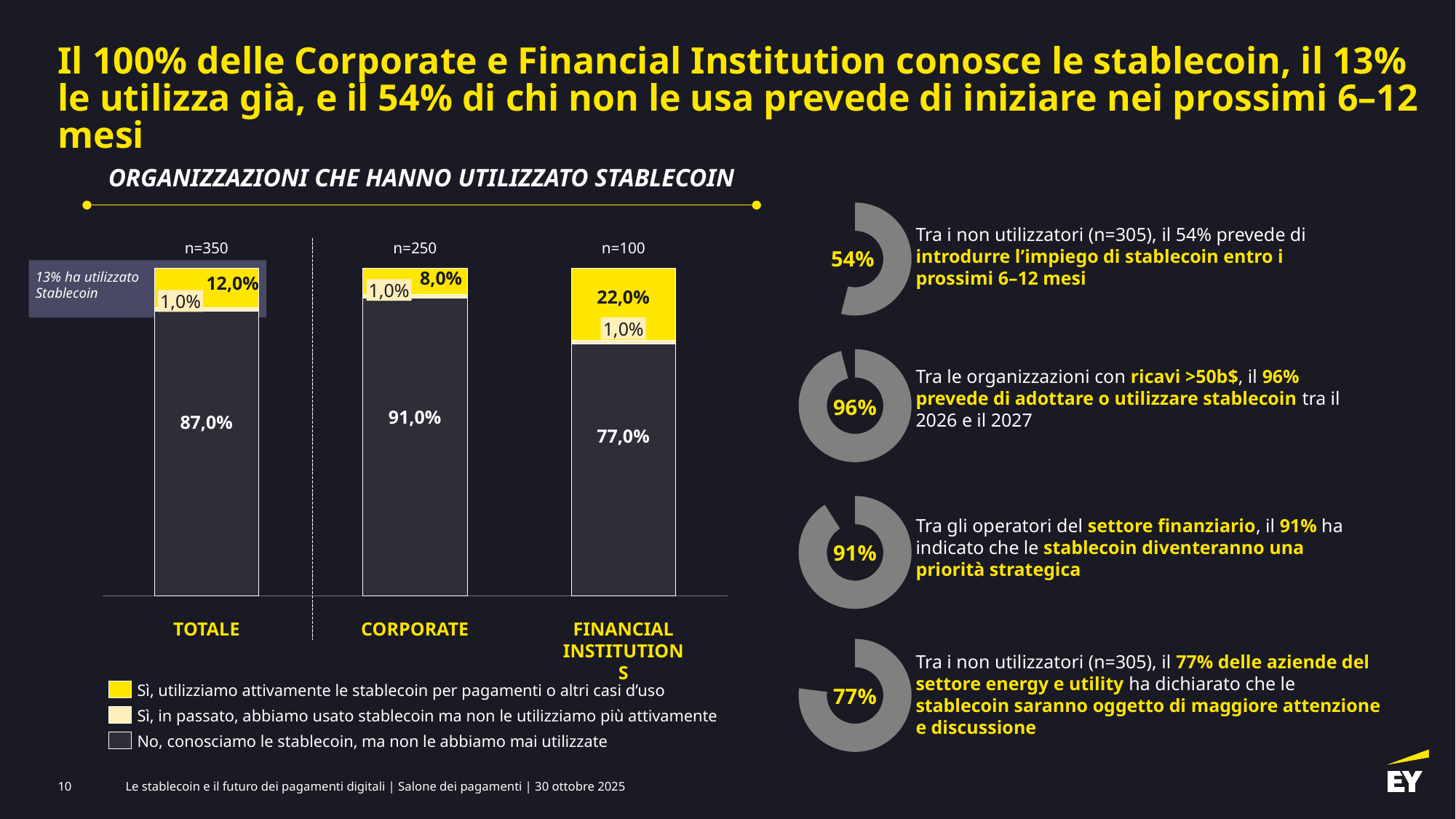
In the chart 'Organizzazioni che hanno utilizzato stablecoin', what percentage of the Totale group used stablecoin in the past but no longer actively use them? 1,0% What kind of chart is 'Organizzazioni che hanno utilizzato stablecoin'? Stacked bar chart In the chart 'Organizzazioni che hanno utilizzato stablecoin', what percentage of Financial Institutions actively use stablecoin for payments or other use cases? 22,0% In the chart 'Organizzazioni che hanno utilizzato stablecoin', what percentage of Corporate respondents know stablecoin but have never used them? 91,0% In the chart 'Organizzazioni che hanno utilizzato stablecoin', what colour represents 'Sì, utilizziamo attivamente le stablecoin per pagamenti o altri casi d'uso'? Yellow How many categories are shown on the x axis of the chart 'Organizzazioni che hanno utilizzato stablecoin'? 3 In the chart 'Organizzazioni che hanno utilizzato stablecoin', is the share of active stablecoin users larger for Corporate or for Financial Institutions? Financial Institutions In the chart 'Organizzazioni che hanno utilizzato stablecoin', which category has the lowest share of respondents who have never used stablecoin? Financial Institutions In the chart 'Organizzazioni che hanno utilizzato stablecoin', what is the difference in percentage points between the 'never used' share for Corporate and for Financial Institutions? 14,0 In the chart 'Organizzazioni che hanno utilizzato stablecoin', what is the sample size (n) shown above the Corporate bar? n=250 How many series does the legend of the chart 'Organizzazioni che hanno utilizzato stablecoin' list? 3 In the chart 'Organizzazioni che hanno utilizzato stablecoin', which category has the highest share of respondents actively using stablecoin? Financial Institutions